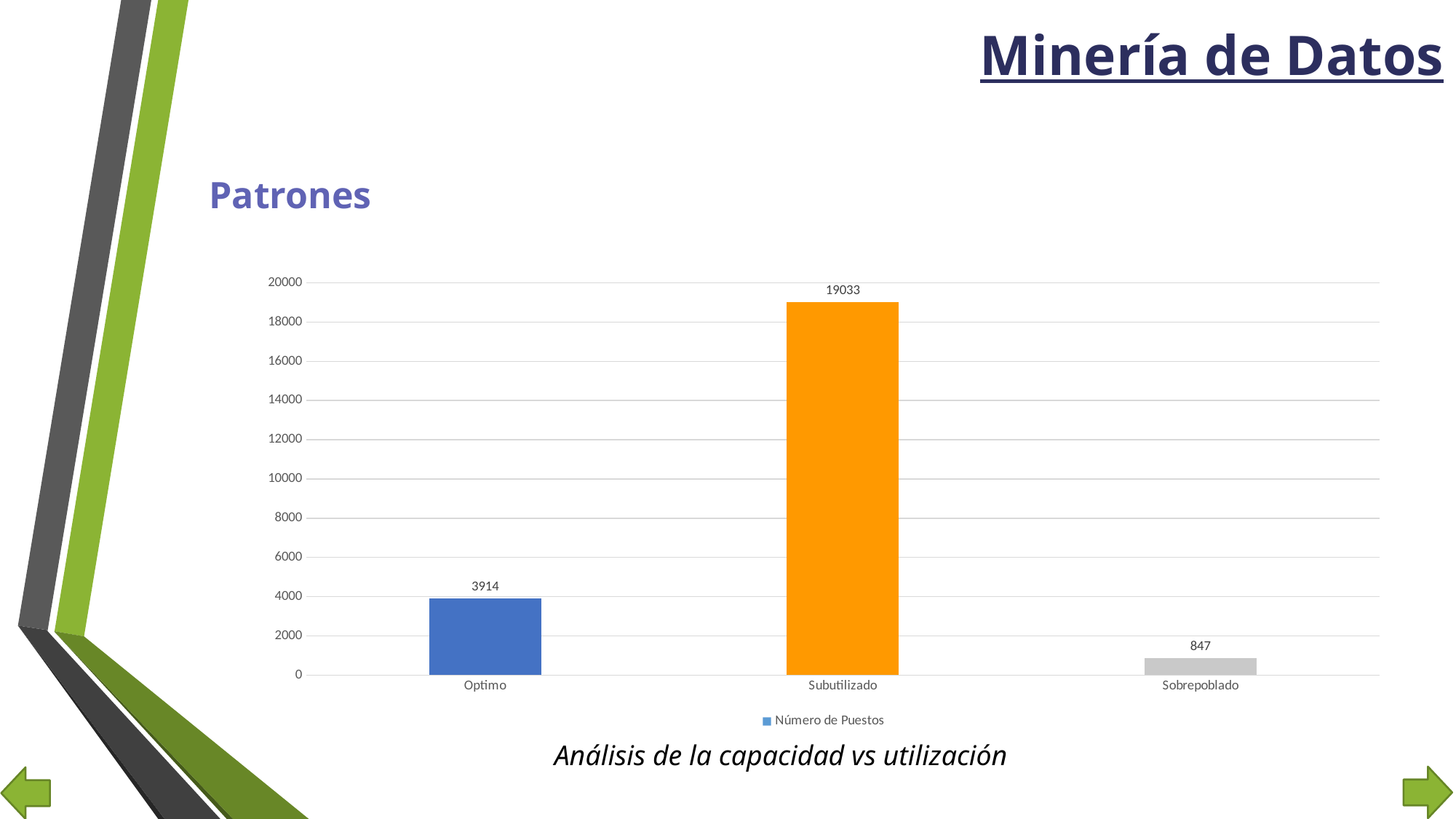
What is the difference between the values for Optimo and Sobrepoblado? 3067 What series name does the legend show? Número de Puestos What kind of chart is shown on the slide? bar chart What is the value for Optimo? 3914 How many categories are shown on the x axis? 3 What is the difference between the values for Subutilizado and Optimo? 15119 Which is larger, the value for Optimo or the value for Sobrepoblado? Optimo What is the value for Subutilizado? 19033 Which category has the highest value? Subutilizado Which category has the lowest value? Sobrepoblado Is the value for Subutilizado greater or less than 18000? greater What is the value for Sobrepoblado? 847